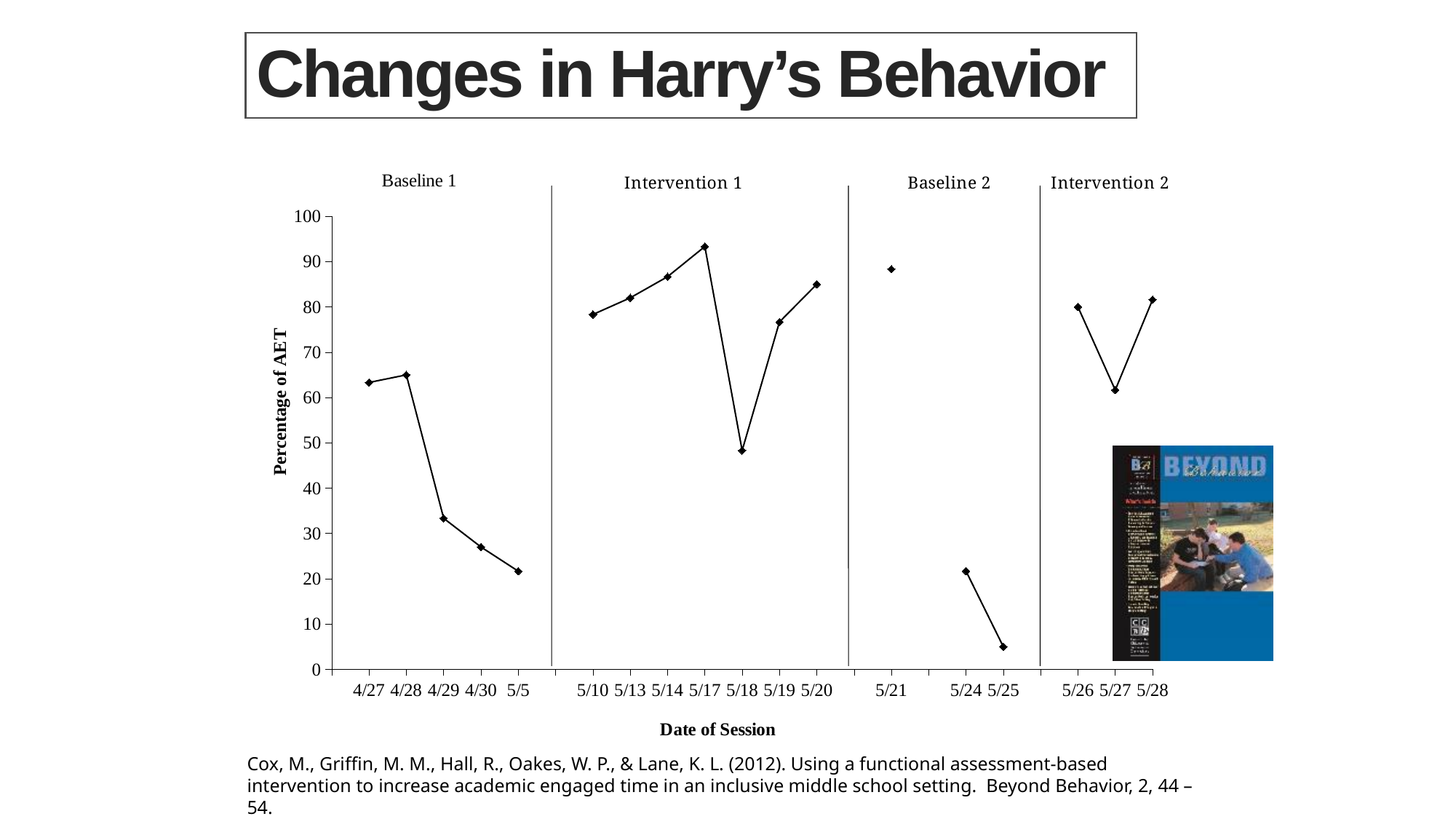
Which session date has the highest percentage of AET? 5/17 Is the percentage of AET for 5/18 greater or less than 60? less Is the percentage of AET for 5/17 greater or less than 90? greater What kind of chart is shown on the slide? line chart What is the label of the y axis? Percentage of AET Which session date has the lowest percentage of AET? 5/25 How many session dates are plotted on the x axis? 18 Is the percentage of AET for 5/5 greater or less than 30? less Do the values rise or fall across the Baseline 1 phase from 4/27 to 5/5? fall Which has a higher percentage of AET, 4/28 or 4/29? 4/28 How many phases are labeled above the chart? 4